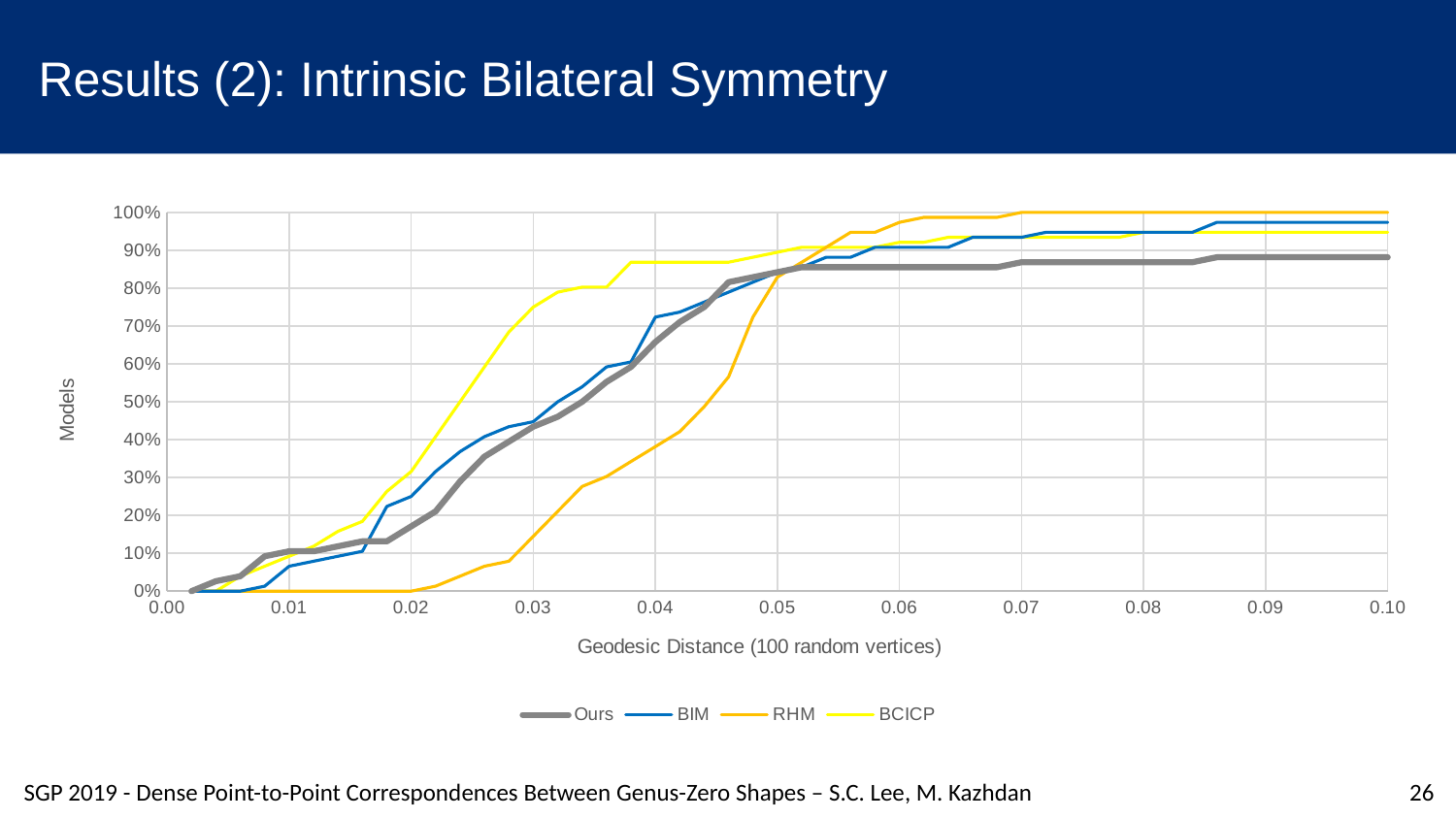
Do the values of the Ours series rise or fall as geodesic distance increases along the x axis? rise Is the value for RHM at a geodesic distance of 0.02 greater or less than 10%? less Which series reaches the highest value at a geodesic distance of 0.10? RHM At a geodesic distance of 0.10, which is larger, the value for RHM or the value for Ours? RHM Which series has the lowest value at a geodesic distance of 0.03? RHM Which series has the highest value at a geodesic distance of 0.03? BCICP What is the title of the x axis? Geodesic Distance (100 random vertices) Is the value for BCICP at a geodesic distance of 0.04 greater or less than 80%? greater Which series has the lowest value at a geodesic distance of 0.10? Ours What kind of chart is shown on the slide? line chart How many series does the legend list? 4 What are the series names listed in the legend? Ours, BIM, RHM, BCICP